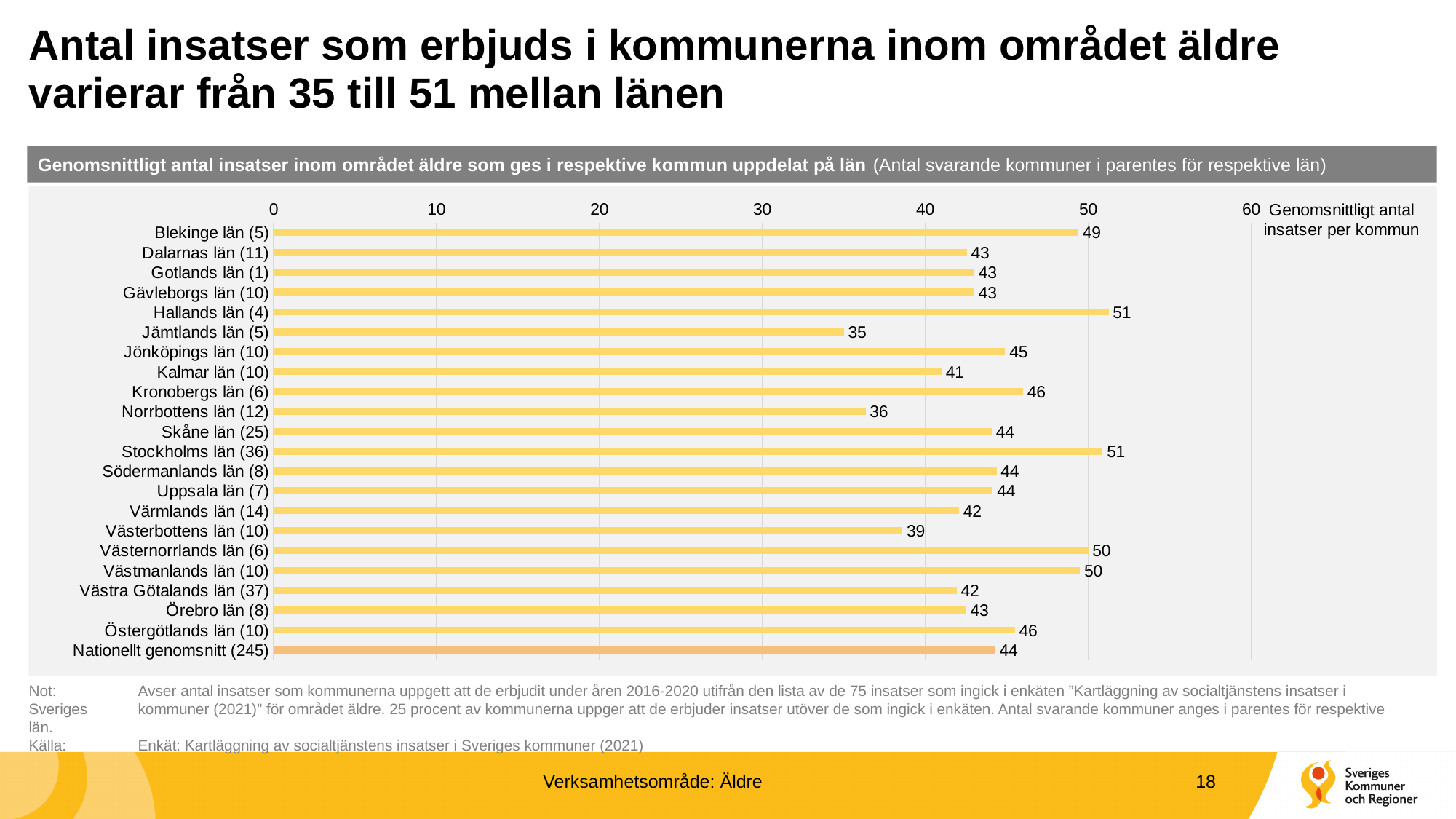
Which bar is shown in a different colour from the others? Nationellt genomsnitt (245) What is the value for Nationellt genomsnitt (245)? 44 What is the value for Jämtlands län (5)? 35 How many bars are plotted in the chart? 22 What is the difference between the values for Kronobergs län (6) and Kalmar län (10)? 5 Which category has the lowest value? Jämtlands län (5) What is the value for Blekinge län (5)? 49 What kind of chart is shown on the slide? Bar chart Is the value for Norrbottens län (12) greater or less than 40? less What is the difference between the values for Hallands län (4) and Jämtlands län (5)? 16 Which is larger, the value for Västernorrlands län (6) or the value for Värmlands län (14)? Västernorrlands län (6) What is the value for Västerbottens län (10)? 39